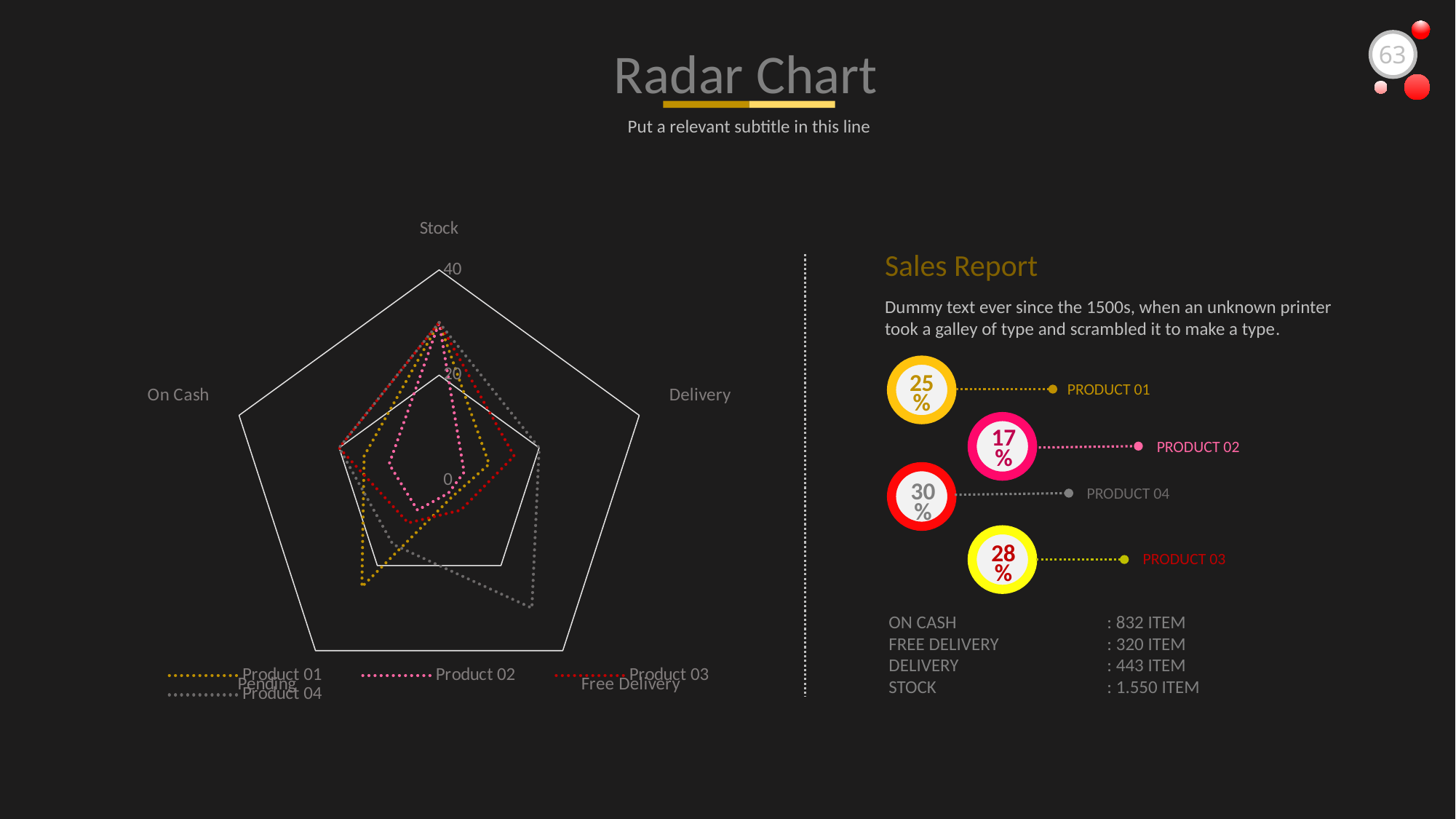
Is the value for Product 03 on the Pending axis greater or less than 20? less Is the value for Product 01 on the Pending axis greater or less than 20? greater Is the value for Product 02 on the Delivery axis greater or less than 20? less Which product has the highest value on the Free Delivery axis? Product 04 Which series is drawn with the pink dotted line in the radar chart? Product 02 How many axes (categories) does the radar chart have? 5 Which product has the highest value on the Pending axis? Product 01 What is the highest value shown on the radar chart's axis scale? 40 How many series does the radar chart's legend list? 4 What kind of chart is shown on the slide? radar chart